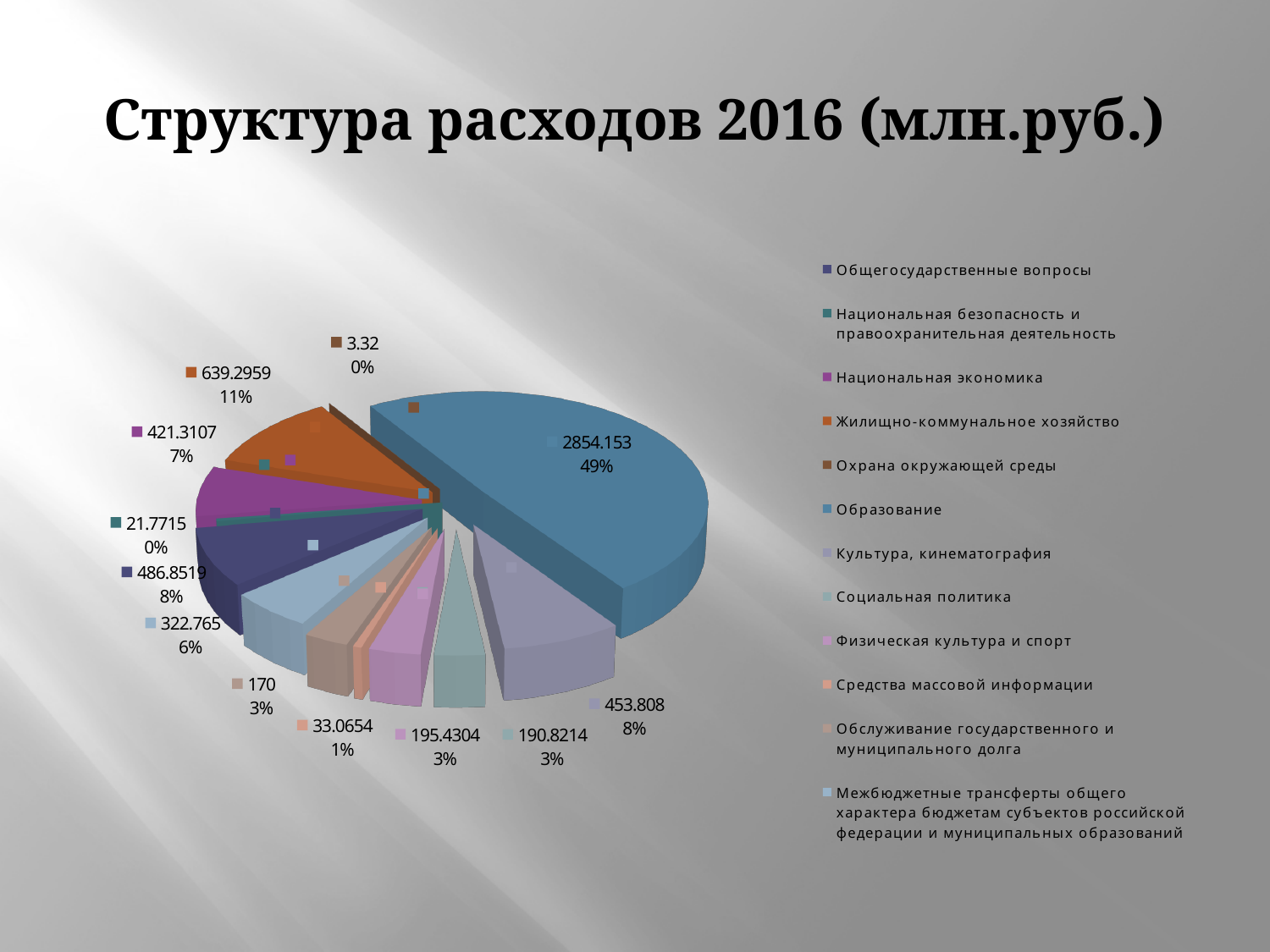
Which category has the smallest slice of the pie? Охрана окружающей среды Which is larger, the value for Общегосударственные вопросы or the value for Культура, кинематография? Общегосударственные вопросы What share of the pie does Образование account for? 49% How many categories does the legend of the pie chart list? 12 What is the value for Обслуживание государственного и муниципального долга? 170 What is the value for Межбюджетные трансферты общего характера бюджетам субъектов российской федерации и муниципальных образований? 322.765 Which category has the largest slice of the pie? Образование What kind of chart is shown on the slide? pie chart What is the title of the chart? Структура расходов 2016 (млн.руб.) What share of the pie does Жилищно-коммунальное хозяйство account for? 11% What is the value for Жилищно-коммунальное хозяйство? 639.2959 What is the difference between the values for Жилищно-коммунальное хозяйство and Национальная экономика? 217.9852